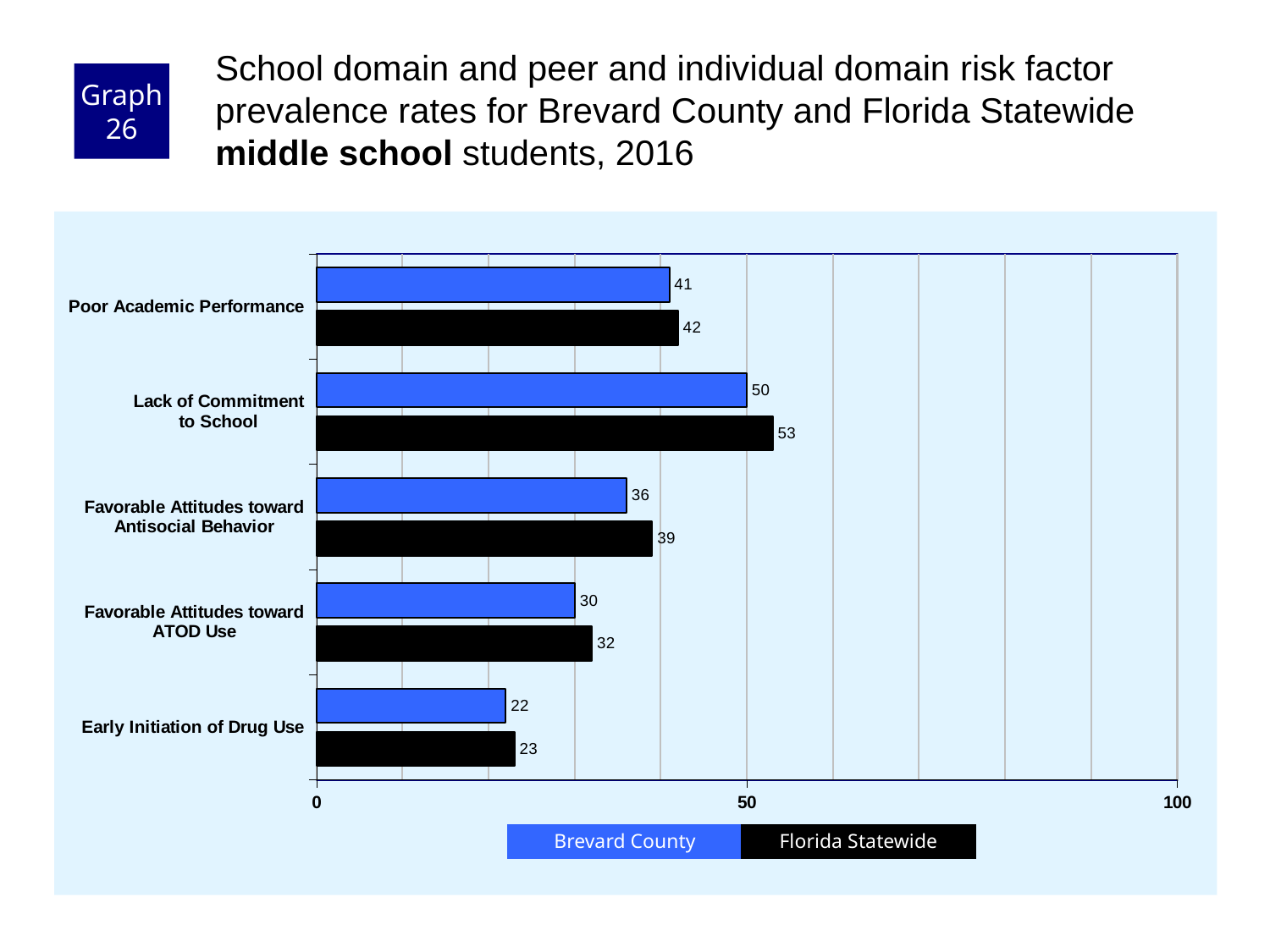
Which risk factor has the lowest Brevard County value? Early Initiation of Drug Use What is the Brevard County value for Early Initiation of Drug Use? 22 Is the Florida Statewide value for Poor Academic Performance greater or less than 50? less What kind of chart is shown on the slide? bar chart What is the difference between the Florida Statewide and Brevard County values for Lack of Commitment to School? 3 How many series does the legend list? 2 Which risk factor has the highest Florida Statewide value? Lack of Commitment to School What is the Brevard County value for Lack of Commitment to School? 50 For Favorable Attitudes toward ATOD Use, which is larger: the Brevard County value or the Florida Statewide value? Florida Statewide What is the Florida Statewide value for Favorable Attitudes toward Antisocial Behavior? 39 How many risk factors are shown on the chart? 5 Which colour represents Brevard County in the chart? blue